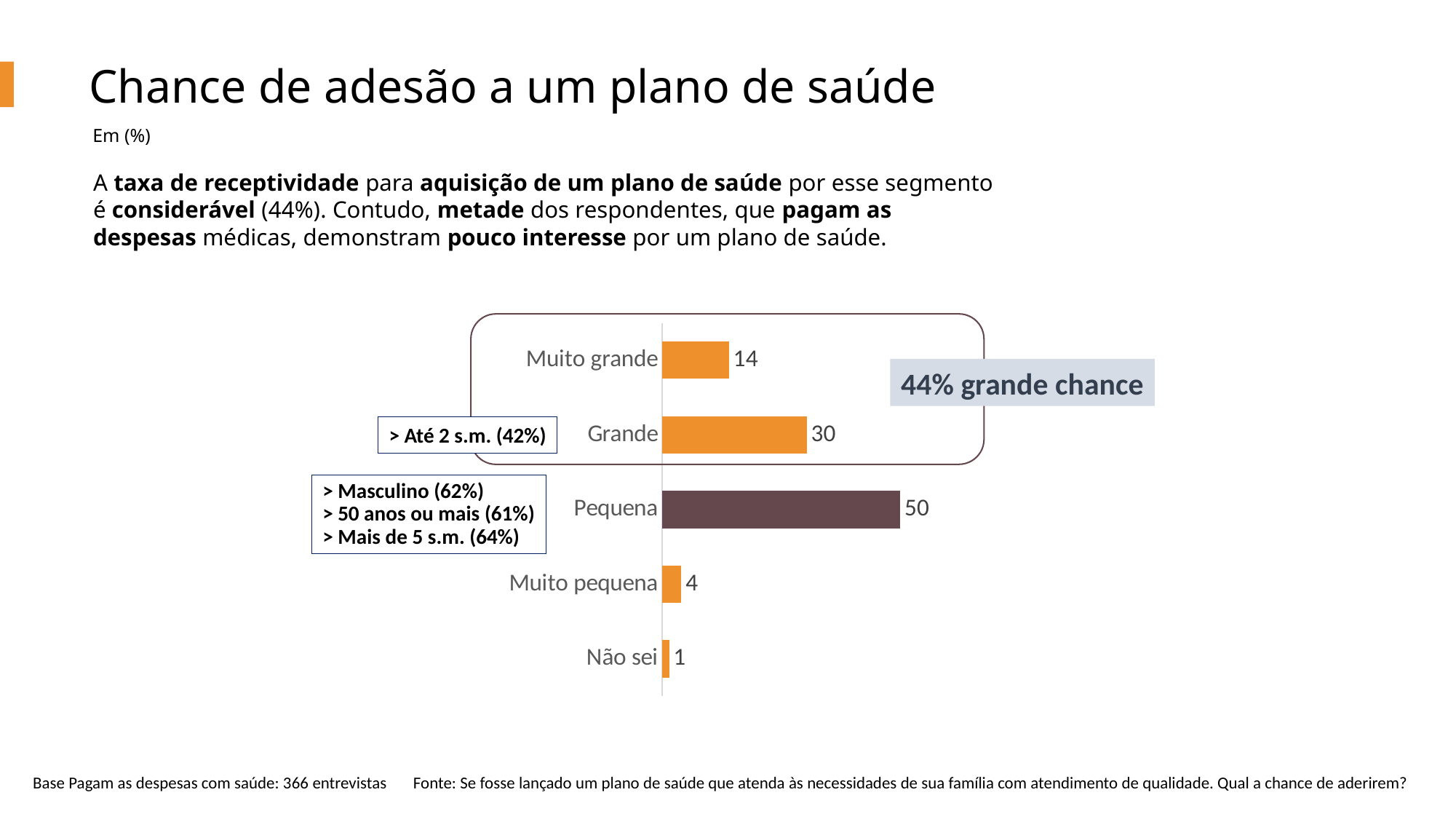
What is the value for "Grande"? 30 Which category has the lowest value? Não sei Which bar is shown in a different colour (dark brown) from the others? Pequena Which is larger, the value for "Muito grande" or the value for "Muito pequena"? Muito grande Which category has the highest value? Pequena What is the value for "Não sei"? 1 What is the difference between the values for "Pequena" and "Grande"? 20 What is the value for "Pequena"? 50 How many categories are shown in the chart? 5 What kind of chart is shown on the slide? Bar chart What is the value for "Muito grande"? 14 What is the combined value of "Muito grande" and "Grande"? 44